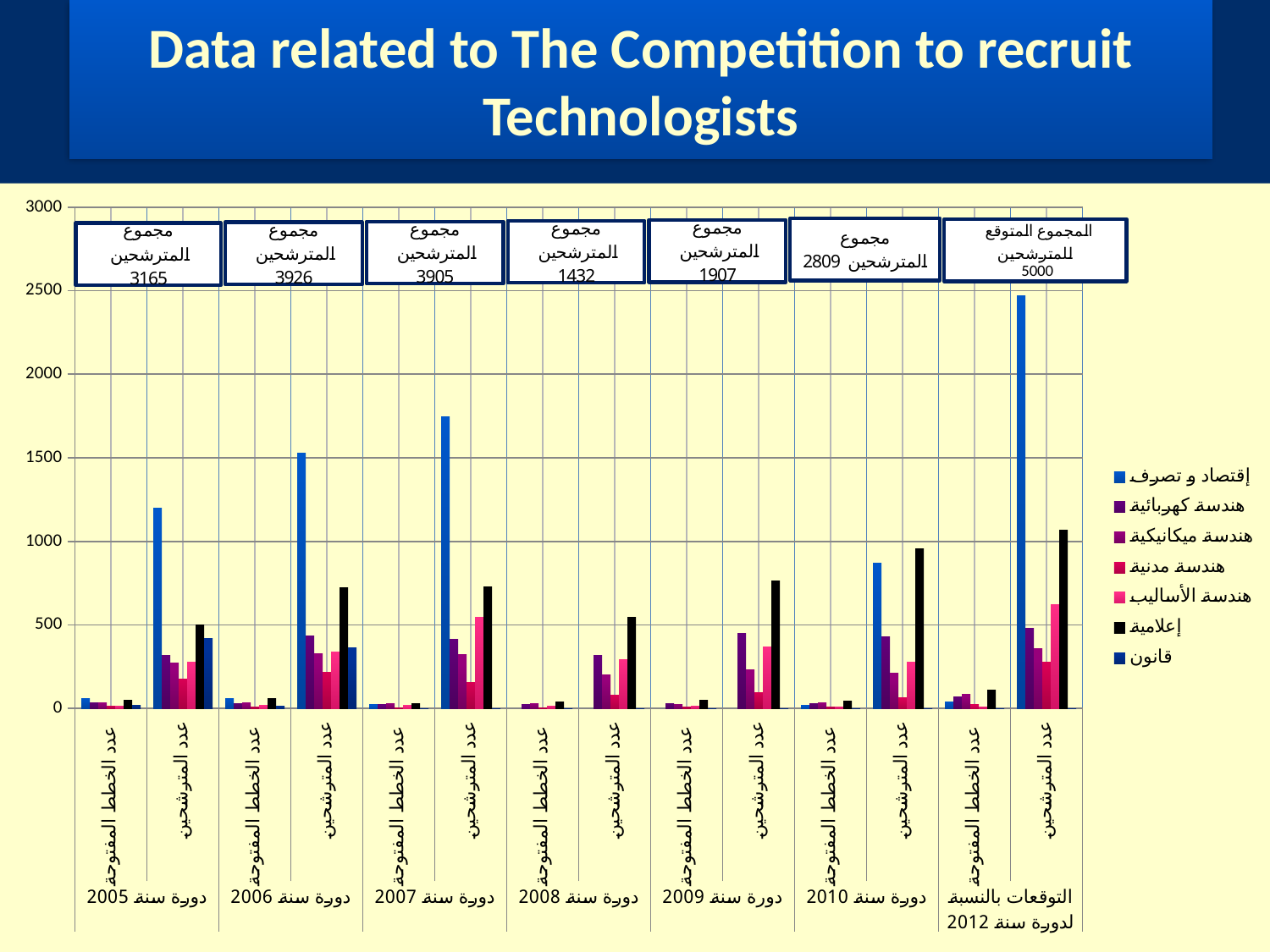
Which series has the tallest bar under عدد المترشحين for التوقعات بالنسبة لدورة سنة 2012? إقتصاد و تصرف What is the total number of candidates (مجموع المترشحين) shown in the box for دورة سنة 2005? 3165 How many series does the legend list? 7 What is the expected total number of candidates (المجموع المتوقع للمترشحين) shown for دورة سنة 2012? 5000 What kind of chart is shown on the slide? bar chart What is the total number of candidates (مجموع المترشحين) shown in the box for دورة سنة 2008? 1432 Which year's box shows the lowest total number of candidates (مجموع المترشحين)? دورة سنة 2008 Which is larger under عدد المترشحين for دورة سنة 2010: the bar for إعلامية or the bar for هندسة كهربائية? إعلامية Is the value for إقتصاد و تصرف under عدد المترشحين for دورة سنة 2007 greater or less than 1500? greater What is the total number of candidates (مجموع المترشحين) shown in the box for دورة سنة 2006? 3926 What is the difference between the total candidates for دورة سنة 2006 (3926) and دورة سنة 2009 (1907)? 2019 Is the value for إقتصاد و تصرف under عدد المترشحين for دورة سنة 2005 greater or less than 1000? greater